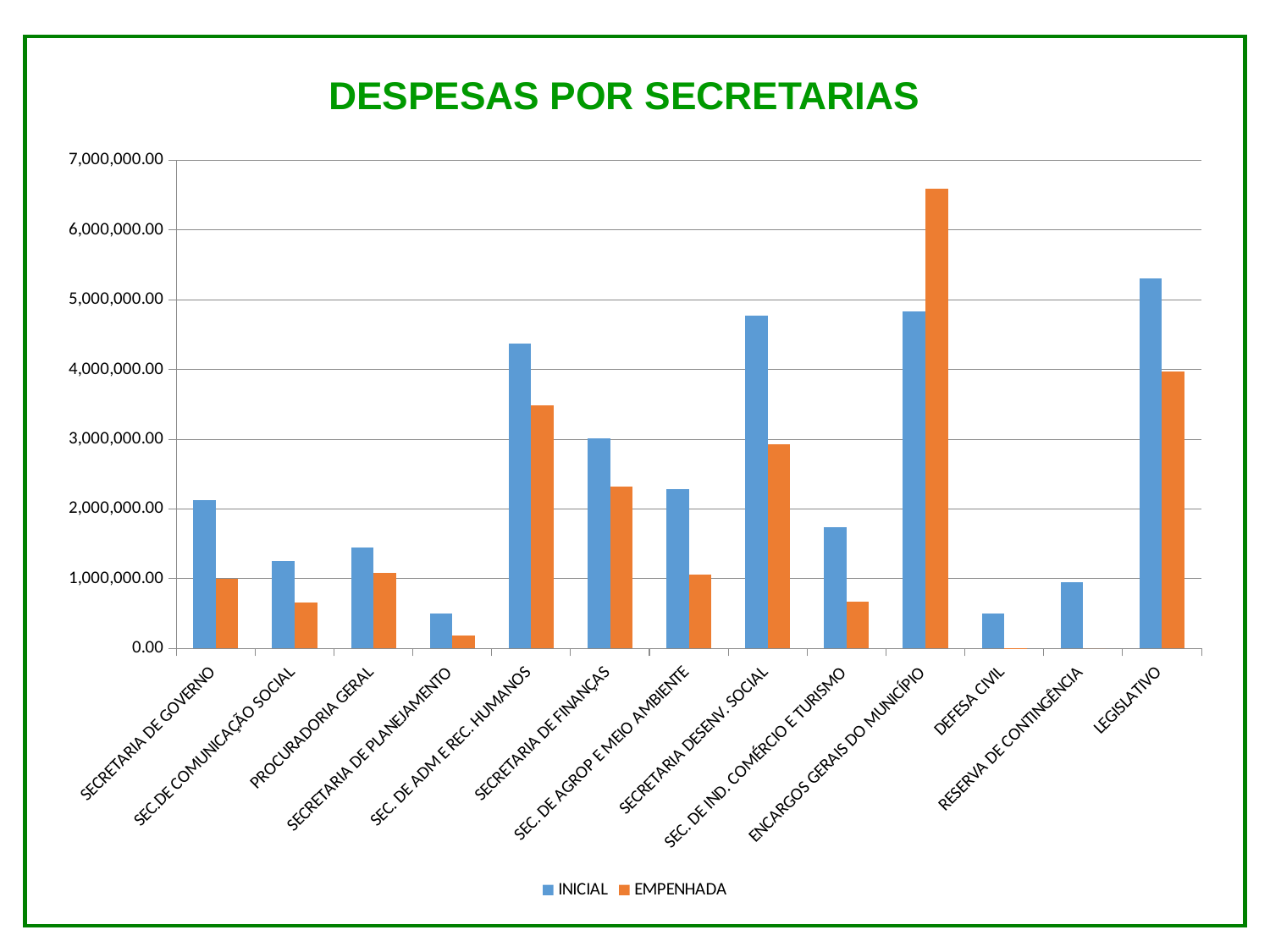
How many series does the legend list? 2 How many categories (secretarias) are shown on the x axis? 13 Which category has the highest INICIAL value? LEGISLATIVO What is the title of the chart? DESPESAS POR SECRETARIAS Is the EMPENHADA value for SEC. DE ADM E REC. HUMANOS greater or less than 3,000,000.00? greater Is the EMPENHADA value for ENCARGOS GERAIS DO MUNICÍPIO greater or less than 6,000,000.00? greater Is the INICIAL value for SEC. DE ADM E REC. HUMANOS greater or less than 4,000,000.00? greater For ENCARGOS GERAIS DO MUNICÍPIO, which is larger, INICIAL or EMPENHADA? EMPENHADA For SECRETARIA DE FINANÇAS, which is larger, INICIAL or EMPENHADA? INICIAL What kind of chart is shown on the slide? bar chart Which category has the highest EMPENHADA value? ENCARGOS GERAIS DO MUNICÍPIO